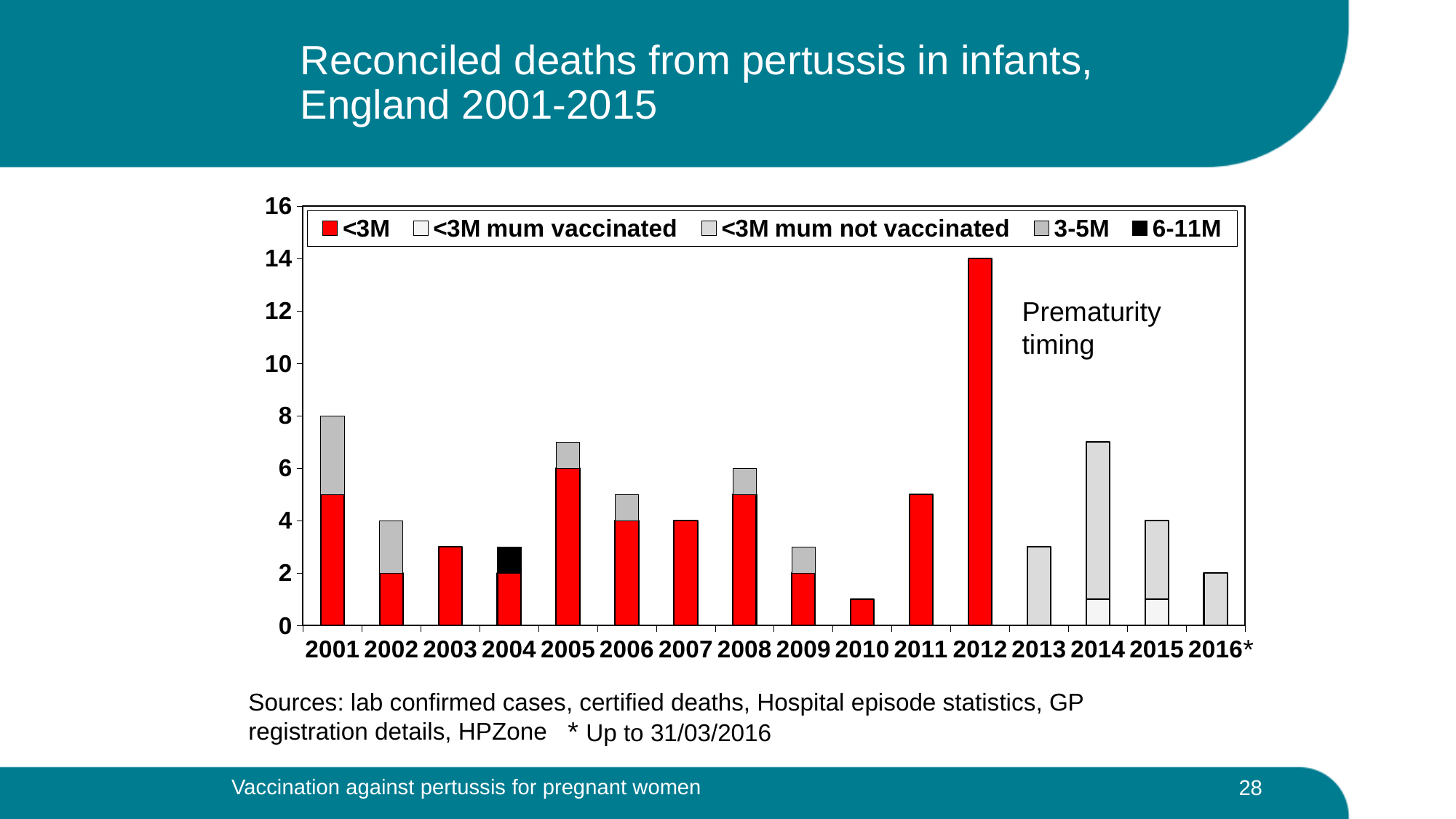
What is the total height of the stacked bar for 2001? 8 Which year has more total deaths, 2012 or 2014? 2012 What is the difference between the total deaths in 2012 and in 2001? 6 What colour represents the <3M series in the legend? Red How many series does the legend list? 5 What is the number of deaths in 2007? 4 Is the total value for 2014 greater or less than 6? greater Which year has the highest total number of deaths? 2012 What type of chart is shown on the slide? Bar chart What is the total number of deaths in 2012? 14 Which year has the lowest total number of deaths? 2010 How many years are shown along the x axis? 16